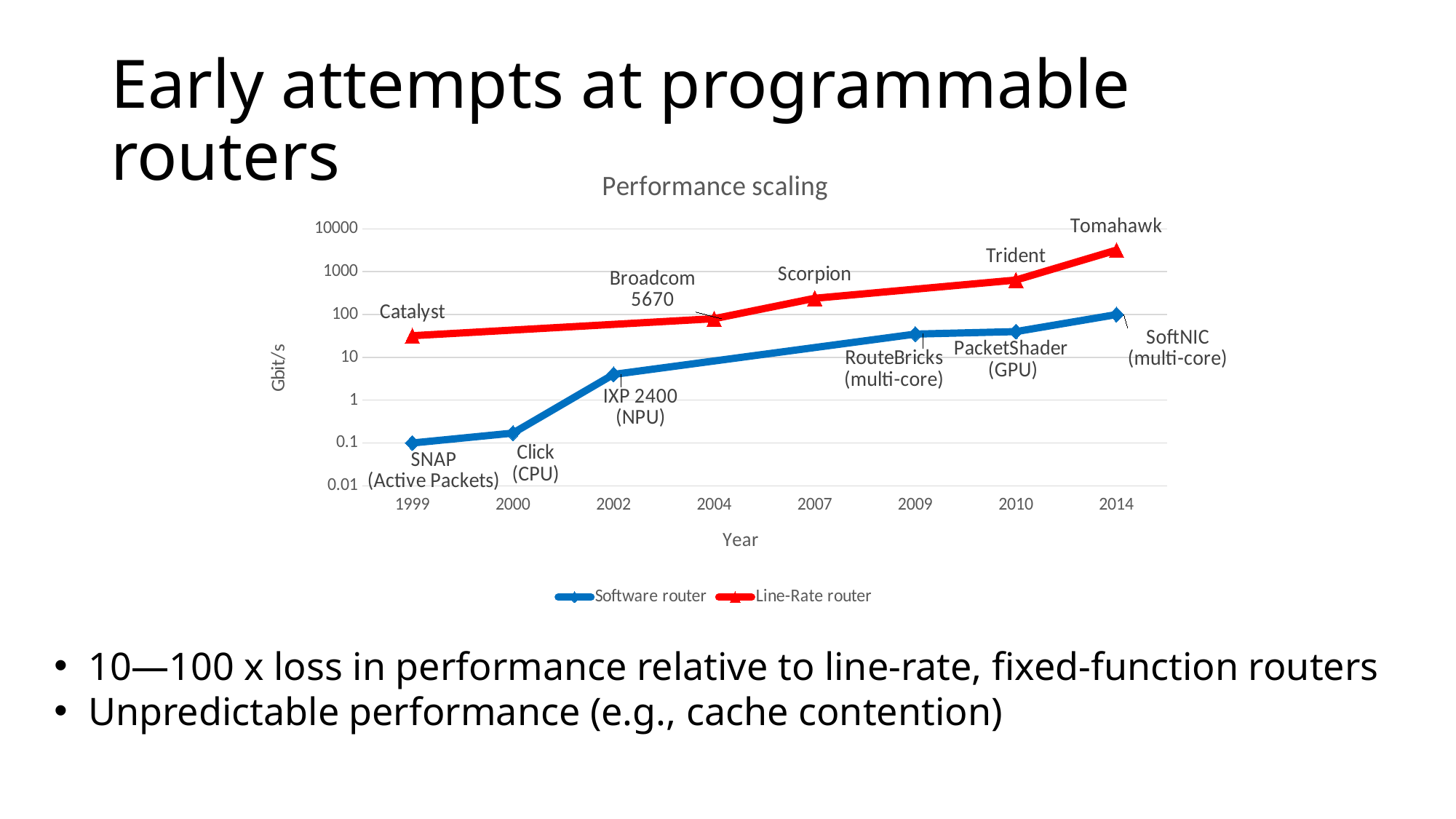
What kind of chart is shown on the slide? line chart Is the Software router value for 2002 (IXP 2400) greater or less than 1? greater Is the Line-Rate router value for 2007 (Scorpion) greater or less than 100? greater What is the label on the y axis? Gbit/s Is the Line-Rate router value for 1999 (Catalyst) greater or less than 100? less How many series does the legend list? 2 How many years are shown on the x axis? 8 In 2014, which series has the higher value, Software router or Line-Rate router? Line-Rate router What is the title of the chart? Performance scaling Do the Software router values rise or fall from 1999 to 2014? rise